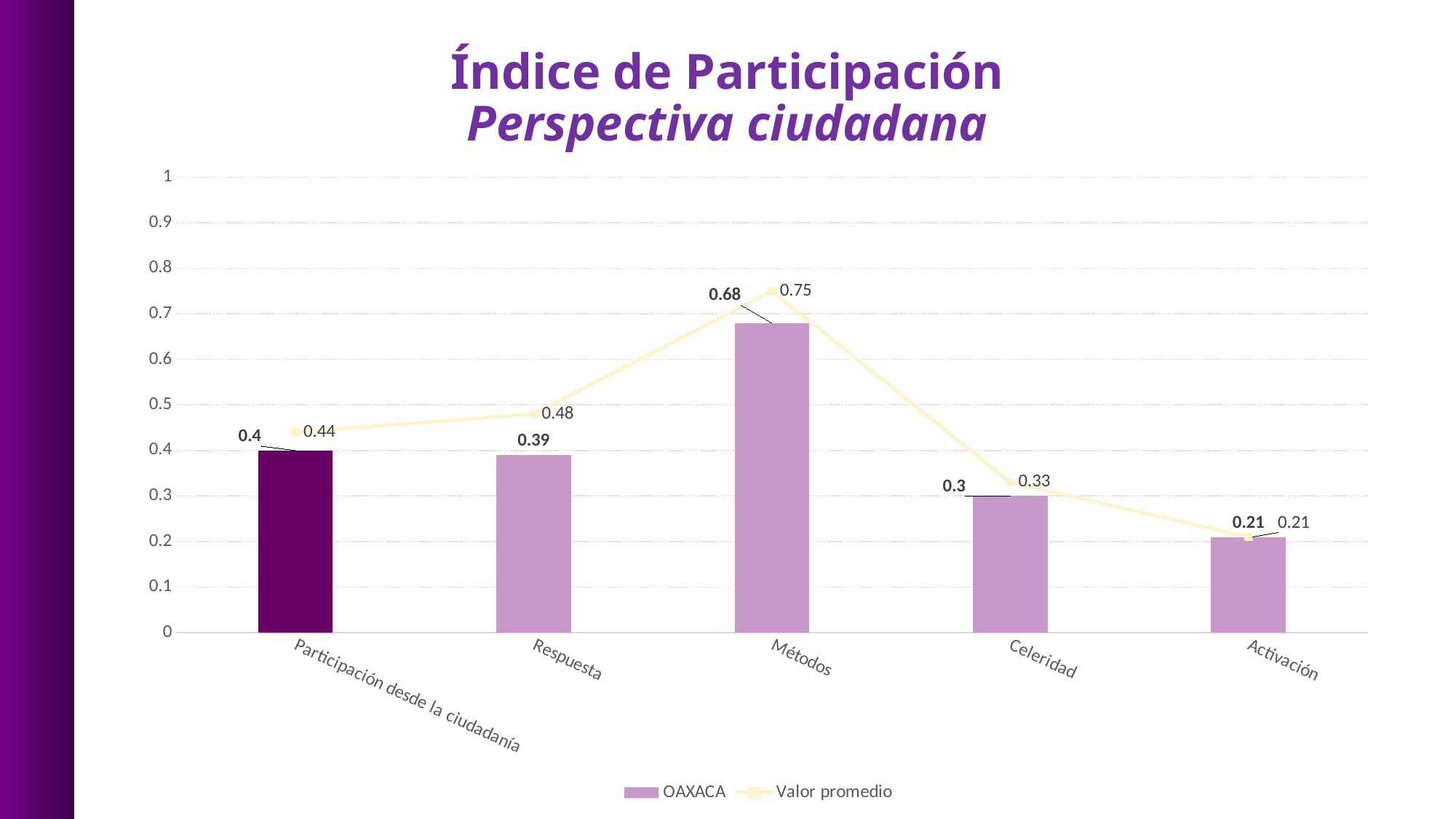
What is the Valor promedio value for Respuesta? 0.48 What is the OAXACA value for Celeridad? 0.3 Which is larger for Celeridad, the OAXACA value or the Valor promedio value? Valor promedio How many categories are shown on the x axis? 5 How many series does the legend list? 2 Which category has the highest OAXACA value? Métodos What is the title of the chart? Índice de Participación Perspectiva ciudadana What is the OAXACA value for Métodos? 0.68 What kind of chart is used for the OAXACA series? Bar chart Which category has the lowest Valor promedio value? Activación What is the Valor promedio value for Participación desde la ciudadanía? 0.44 What is the difference between the Valor promedio and OAXACA values for Métodos? 0.07